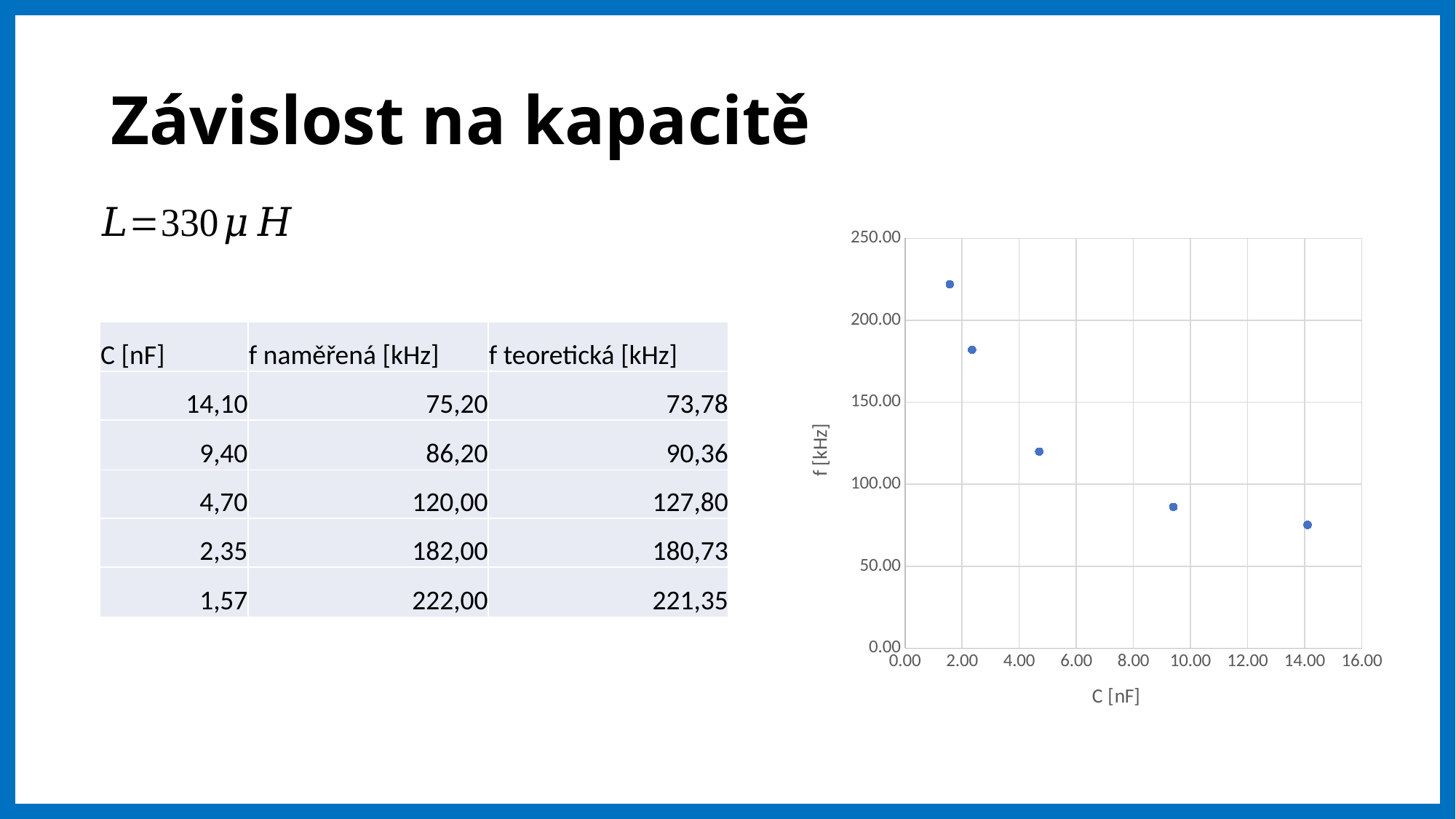
Is the f value of the point at about 2.35 nF greater or less than 150.00? greater Is the f value of the point at about 4.7 nF greater or less than 100.00? greater Is the f value of the leftmost point (smallest C) greater or less than 200.00? greater How many data points are plotted in the chart? 5 As C increases along the x axis, do the plotted f values rise or fall? fall What is the title of the y axis of the chart? f [kHz] What is the title of the x axis of the chart? C [nF] Does the point with the highest f value have the smallest or the largest C? smallest What kind of chart is shown on the slide? scatter chart Which point has a higher f value: the one at about 2 nF or the one at about 14 nF? the one at about 2 nF